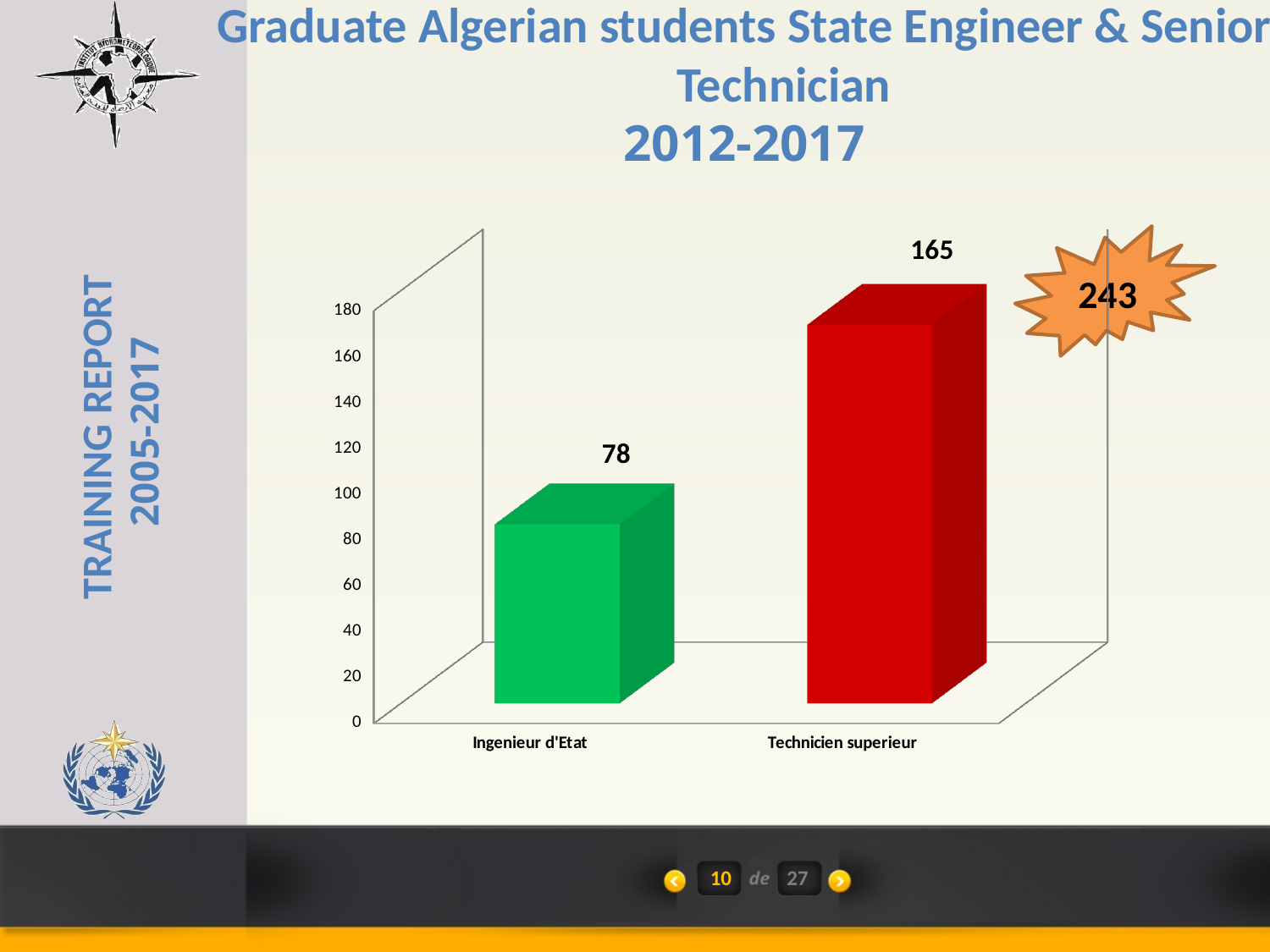
What is the difference between the values for Technicien superieur and Ingenieur d'Etat? 87 Is the value for Ingenieur d'Etat greater or less than 100? less What is the total of the two bar values shown on the chart? 243 What kind of chart is shown on the slide? bar chart Is the value for Technicien superieur greater or less than 140? greater Which category has the highest value? Technicien superieur Which category has the lowest value? Ingenieur d'Etat How many categories are shown on the x axis? 2 What is the value for Ingenieur d'Etat? 78 What colour is the bar for Technicien superieur? red Which is larger, the value for Ingenieur d'Etat or the value for Technicien superieur? Technicien superieur What is the value for Technicien superieur? 165